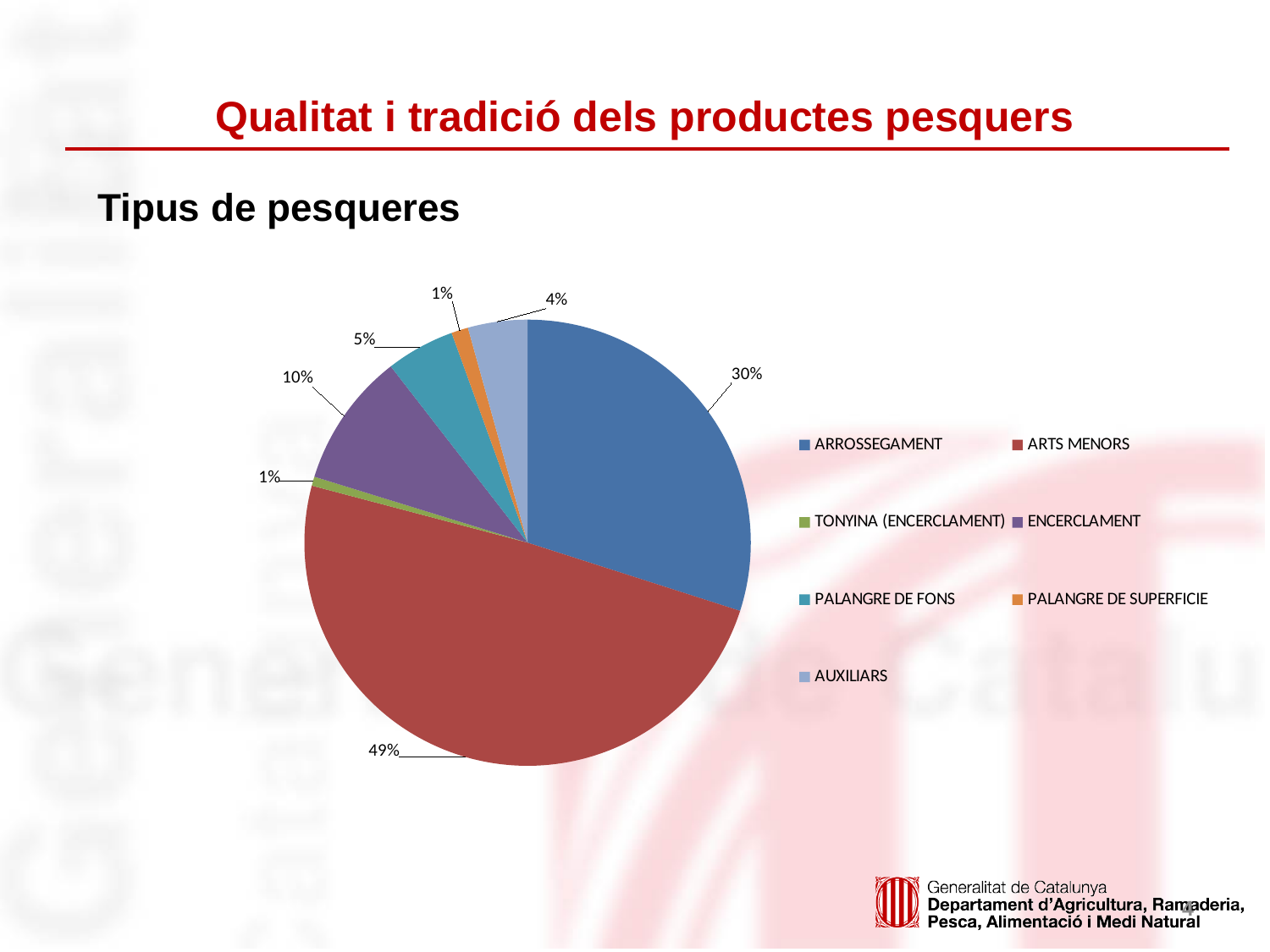
What is the difference in percentage points between ARTS MENORS and ARROSSEGAMENT? 19 Which colour represents ARTS MENORS in the legend? red Which is larger, the slice for ARROSSEGAMENT or the slice for ENCERCLAMENT? ARROSSEGAMENT What share of the pie does ARTS MENORS represent? 49% What share of the pie does ENCERCLAMENT represent? 10% What share of the pie does PALANGRE DE FONS represent? 5% How many categories does the legend list? 7 What type of chart is shown on the slide? pie chart Which category has the largest slice of the pie? ARTS MENORS What is the title shown above the chart? Tipus de pesqueres